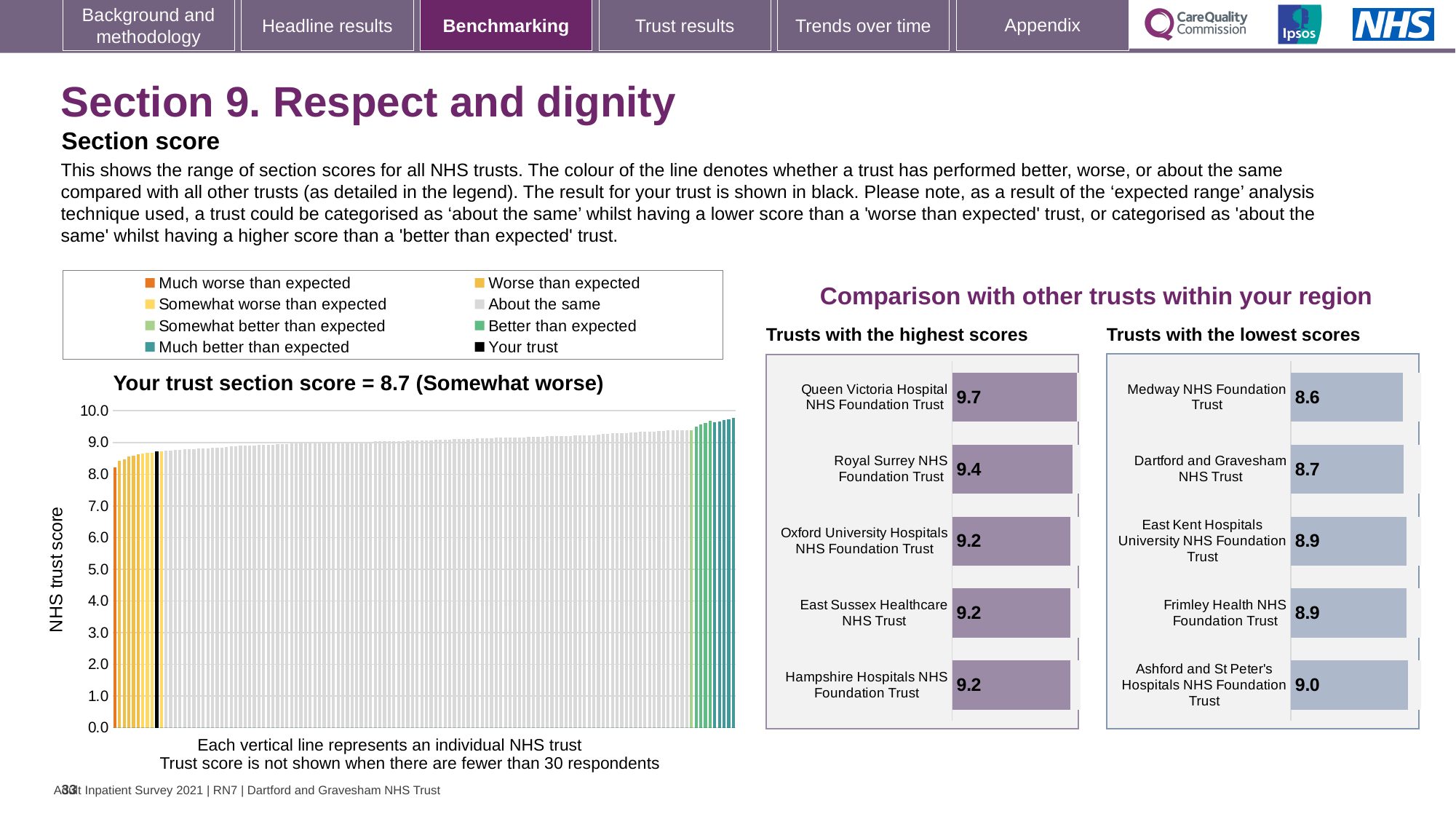
In the 'Trusts with the lowest scores' chart, which trust has the lowest score? Medway NHS Foundation Trust In the 'Trusts with the lowest scores' chart, what is the score for Medway NHS Foundation Trust? 8.6 In the 'Trusts with the highest scores' chart, what is the difference between the scores of Queen Victoria Hospital NHS Foundation Trust and Royal Surrey NHS Foundation Trust? 0.3 In the 'Trusts with the highest scores' chart, which has the higher score: Royal Surrey NHS Foundation Trust or Oxford University Hospitals NHS Foundation Trust? Royal Surrey NHS Foundation Trust In the 'Trusts with the highest scores' chart, what is the score for Queen Victoria Hospital NHS Foundation Trust? 9.7 In the 'Trusts with the highest scores' chart, which trust has the highest score? Queen Victoria Hospital NHS Foundation Trust What kind of chart is the 'Trusts with the lowest scores' chart? Bar chart In the 'Trusts with the lowest scores' chart, what is the difference between the scores of Ashford and St Peter's Hospitals NHS Foundation Trust and Medway NHS Foundation Trust? 0.4 How many trusts are shown in the 'Trusts with the highest scores' chart? 5 In the 'Trusts with the lowest scores' chart, what is the score for Dartford and Gravesham NHS Trust? 8.7 In the main chart on the left, is the highest trust score greater or less than 10.0? less According to the title of the main chart on the left, what is your trust's section score? 8.7